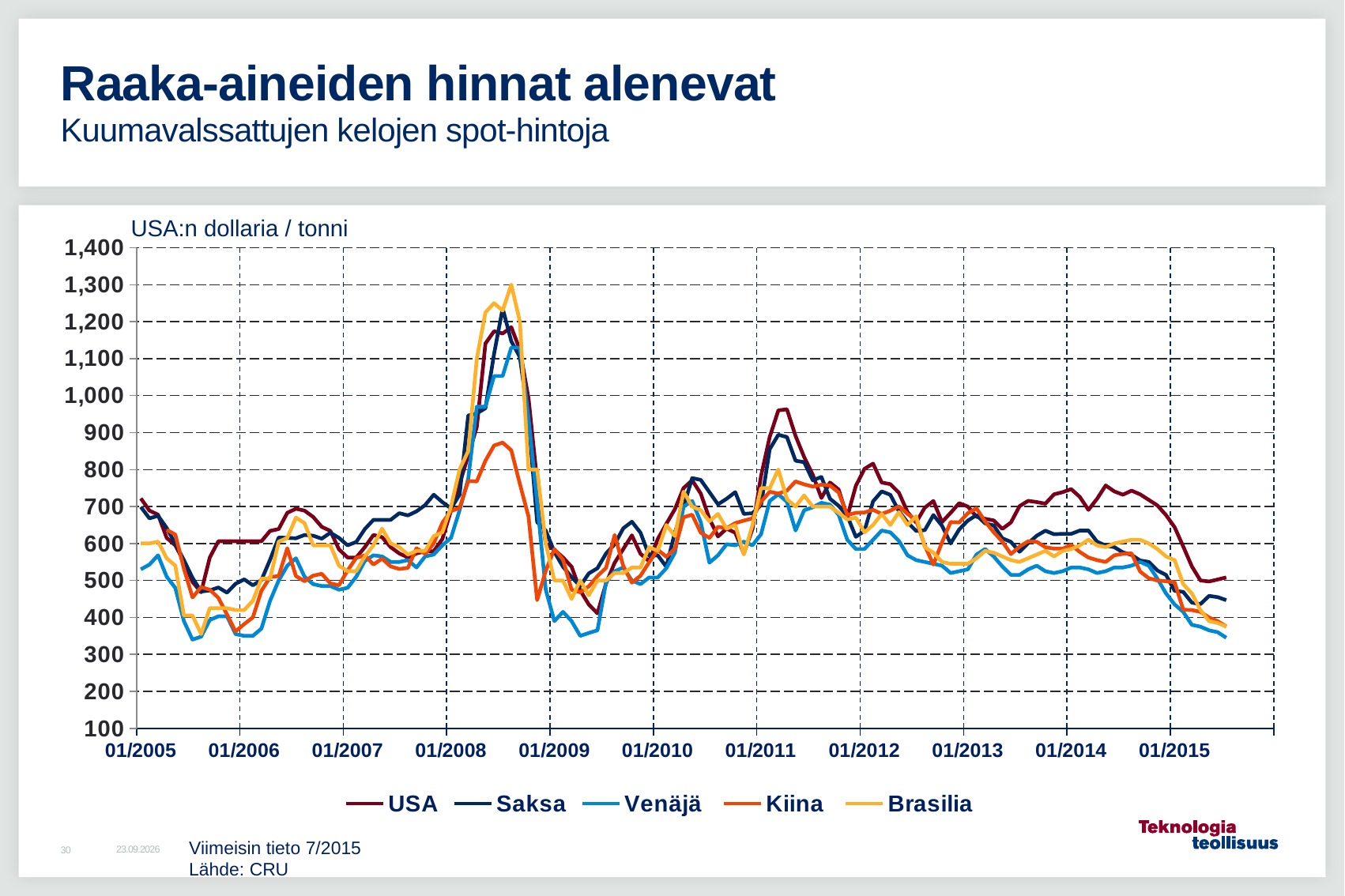
From 01/2014 to the end of the series, does the USA line rise or fall overall? fall What unit is given above the y axis? USA:n dollaria / tonni How many year labels are shown on the x axis? 11 Is the peak value for Kiina in 2008 greater or less than 1,000? less Which series has the lowest value in mid-2009? Venäjä What kind of chart is shown on the slide? line chart Which series reaches the highest value during the 2008 peak? Brasilia Is the peak value for Brasilia in 2008 greater or less than 1,200? greater At 01/2014, which is larger, the value for USA or the value for Venäjä? USA How many series does the legend list? 5 Is the value for Venäjä at 01/2005 greater or less than 600? less Which series are listed in the legend? USA, Saksa, Venäjä, Kiina, Brasilia